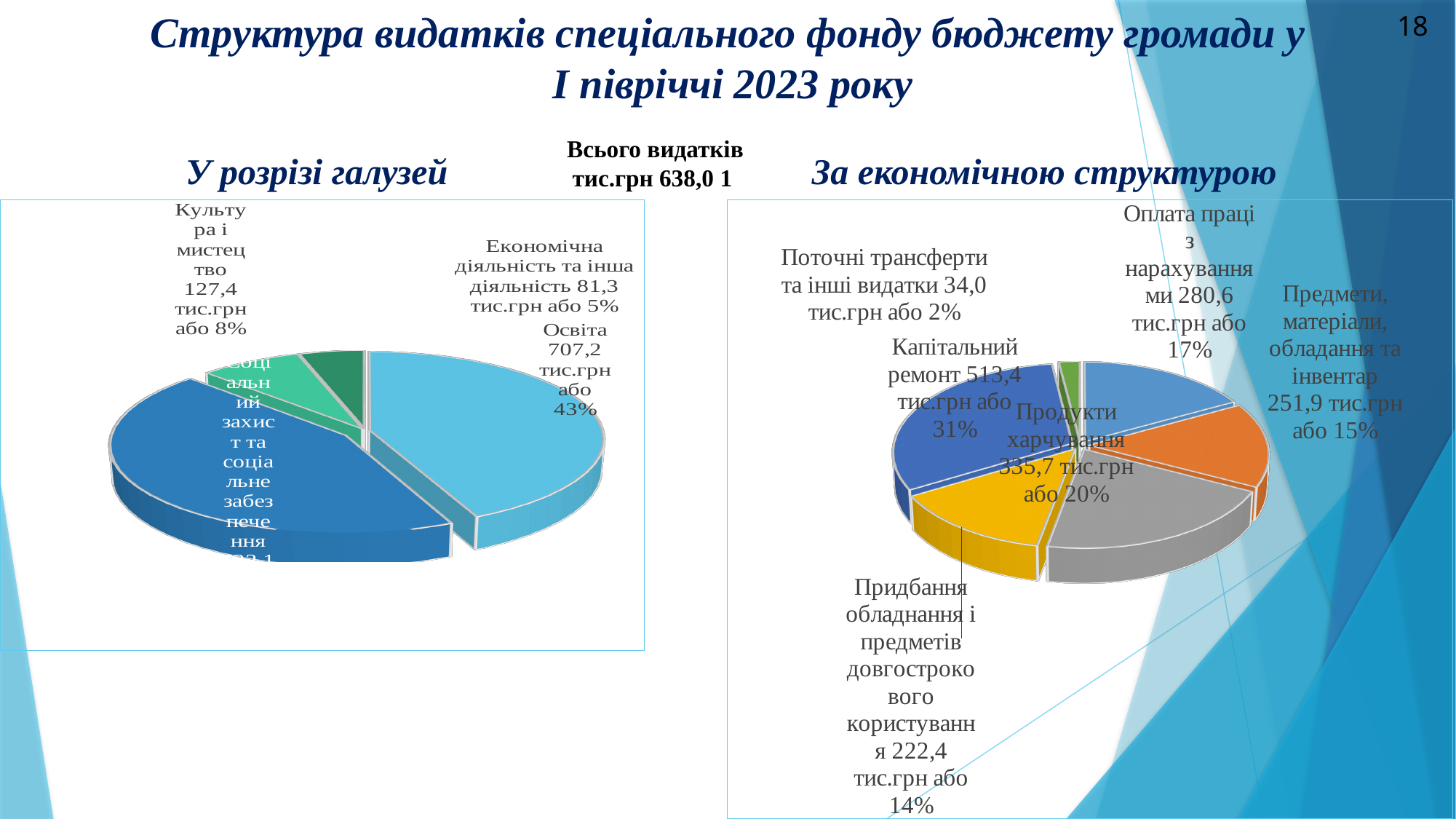
In the 'У розрізі галузей' chart, what is the value for Освіта? 707,2 тис.грн In the 'У розрізі галузей' chart, what share of the pie does Освіта take? 43% What type of chart is used on the slide for 'У розрізі галузей'? pie chart In the 'За економічною структурою' chart, which is larger: Оплата праці з нарахуваннями or Предмети, матеріали, обладнання та інвентар? Оплата праці з нарахуваннями In the 'За економічною структурою' chart, what is the difference in percentage points between Капітальний ремонт and Придбання обладнання і предметів довгострокового користування? 17 percentage points In the 'За економічною структурою' chart, what is the value for Капітальний ремонт? 513,4 тис.грн In the 'За економічною структурою' chart, which category has the smallest share? Поточні трансферти та інші видатки In the 'У розрізі галузей' chart, what is the value for Культура і мистецтво? 127,4 тис.грн In the 'У розрізі галузей' chart, how many slices does the pie have? 4 In the 'За економічною структурою' chart, which category has the largest share? Капітальний ремонт In the 'За економічною структурою' chart, what share of the pie does Продукти харчування take? 20% In the 'У розрізі галузей' chart, which category has the smallest share? Економічна діяльність та інша діяльність